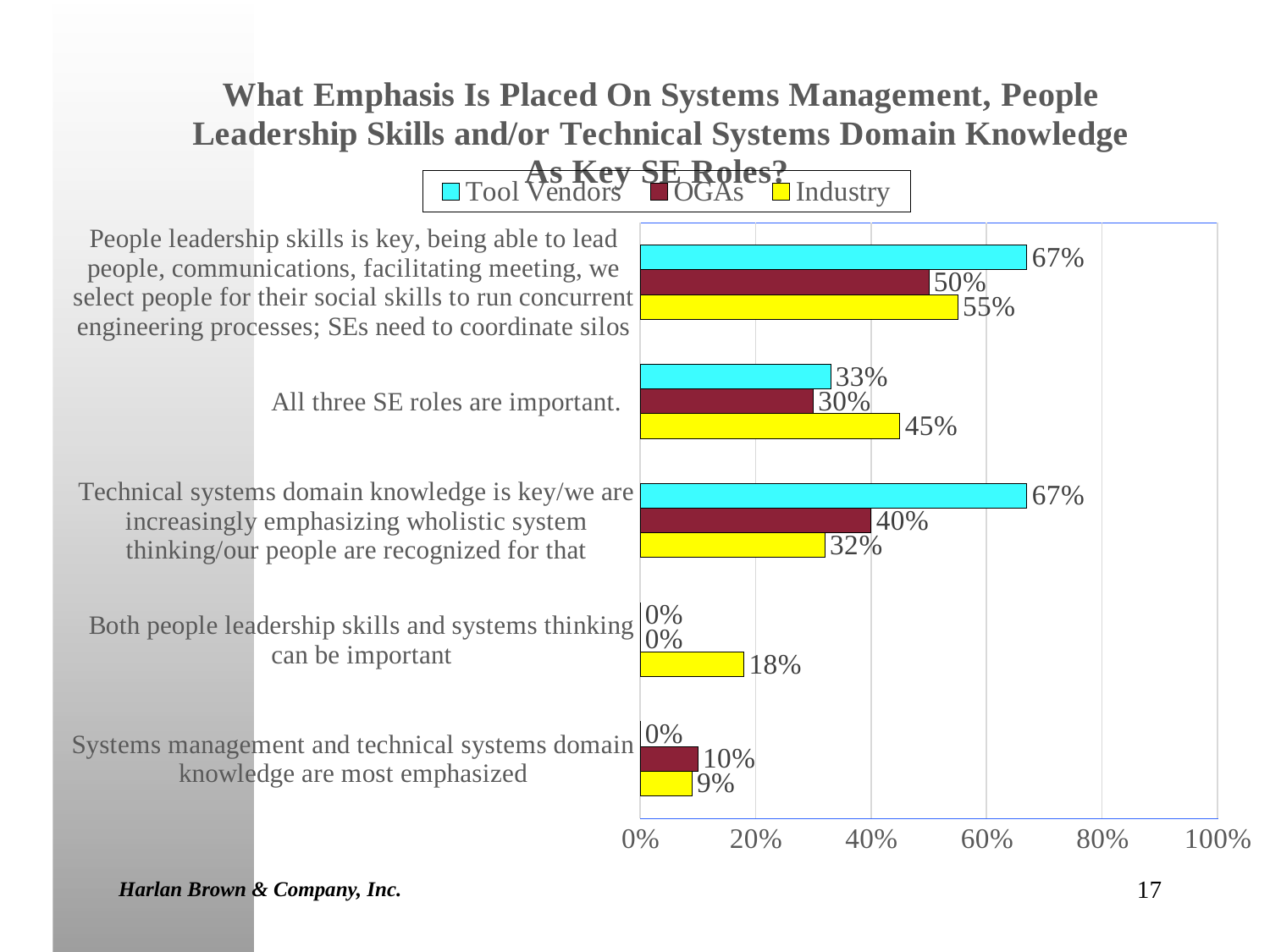
What is the difference between the Tool Vendors and OGAs values for "People leadership skills is key..."? 17% What is the Industry value for "Both people leadership skills and systems thinking can be important"? 18% Which series is shown in yellow in the legend? Industry What kind of chart is shown on the slide? Bar chart For "All three SE roles are important.", which is larger: the Tool Vendors value or the Industry value? Industry How many categories are shown on the chart? 5 What is the Tool Vendors value for "Technical systems domain knowledge is key/we are increasingly emphasizing wholistic system thinking/our people are recognized for that"? 67% Which category has the lowest OGAs value? Both people leadership skills and systems thinking can be important What is the OGAs value for "Systems management and technical systems domain knowledge are most emphasized"? 10% How many series does the legend list? 3 What is the Industry value for "All three SE roles are important."? 45%